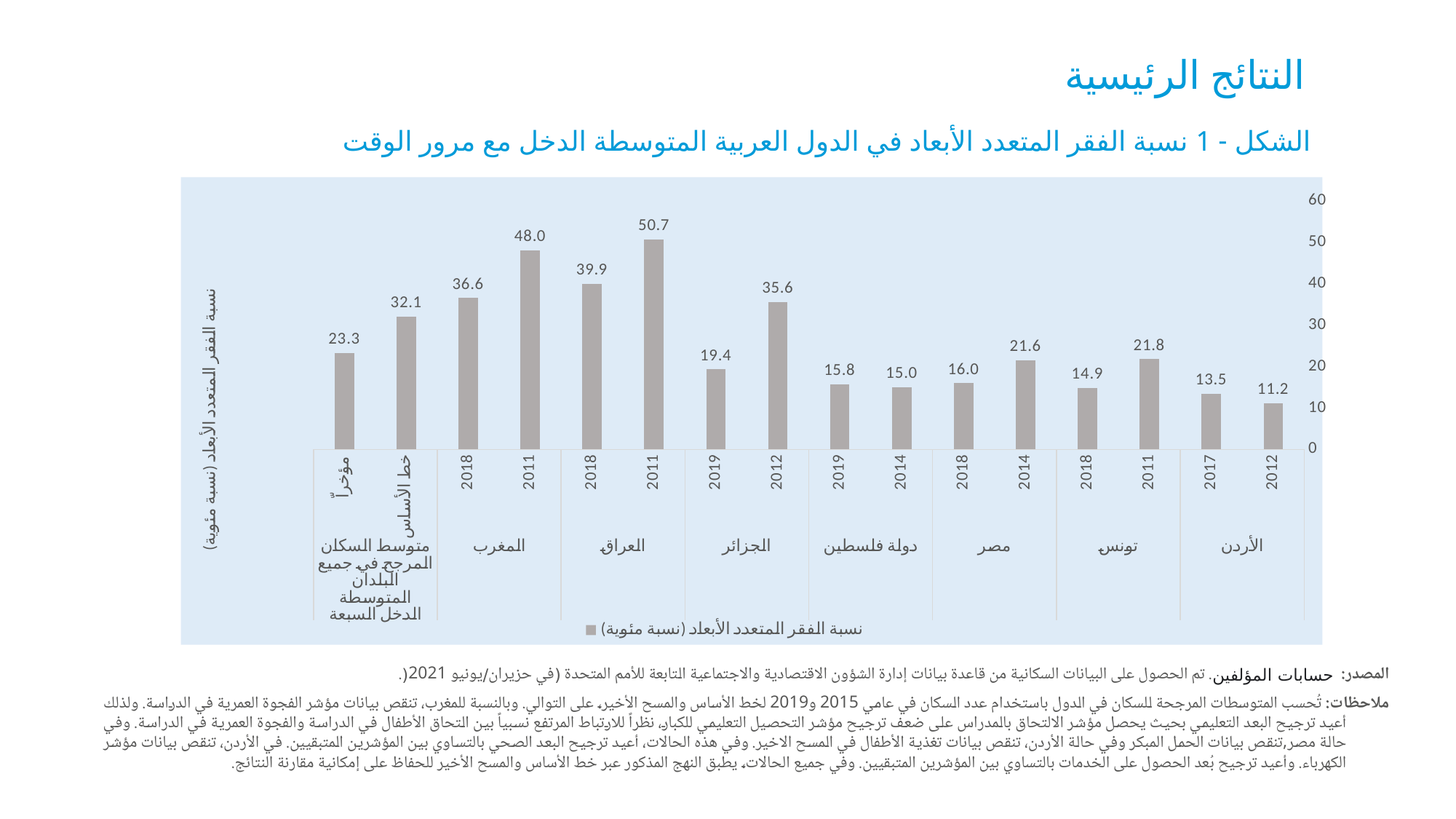
ما الفرق بين قيمة الجزائر عام 2012 وقيمتها عام 2019؟ 16.2 ما نوع الرسم البياني المستخدم في الشكل 1؟ رسم بياني بالأعمدة (bar chart) ما قيمة متوسط السكان المرجح في جميع البلدان المتوسطة الدخل السبعة مؤخراً؟ 23.3 هل قيمة العراق عام 2018 أكبر أم أقل من 40؟ أقل أي عمود يمثل أعلى قيمة في الشكل؟ العراق 2011 ما قيمة نسبة الفقر المتعدد الأبعاد في العراق عام 2011؟ 50.7 كم عدد الأعمدة المرسومة في الشكل؟ 16 ما الفرق بين قيمة المغرب عام 2011 وقيمته عام 2018؟ 11.4 أي عمود يمثل أدنى قيمة في الشكل؟ الأردن 2012 ما قيمة نسبة الفقر المتعدد الأبعاد في المغرب عام 2018؟ 36.6 أيهما أكبر: قيمة تونس عام 2011 أم قيمة مصر عام 2014؟ تونس 2011 ما قيمة نسبة الفقر المتعدد الأبعاد في الأردن عام 2012؟ 11.2